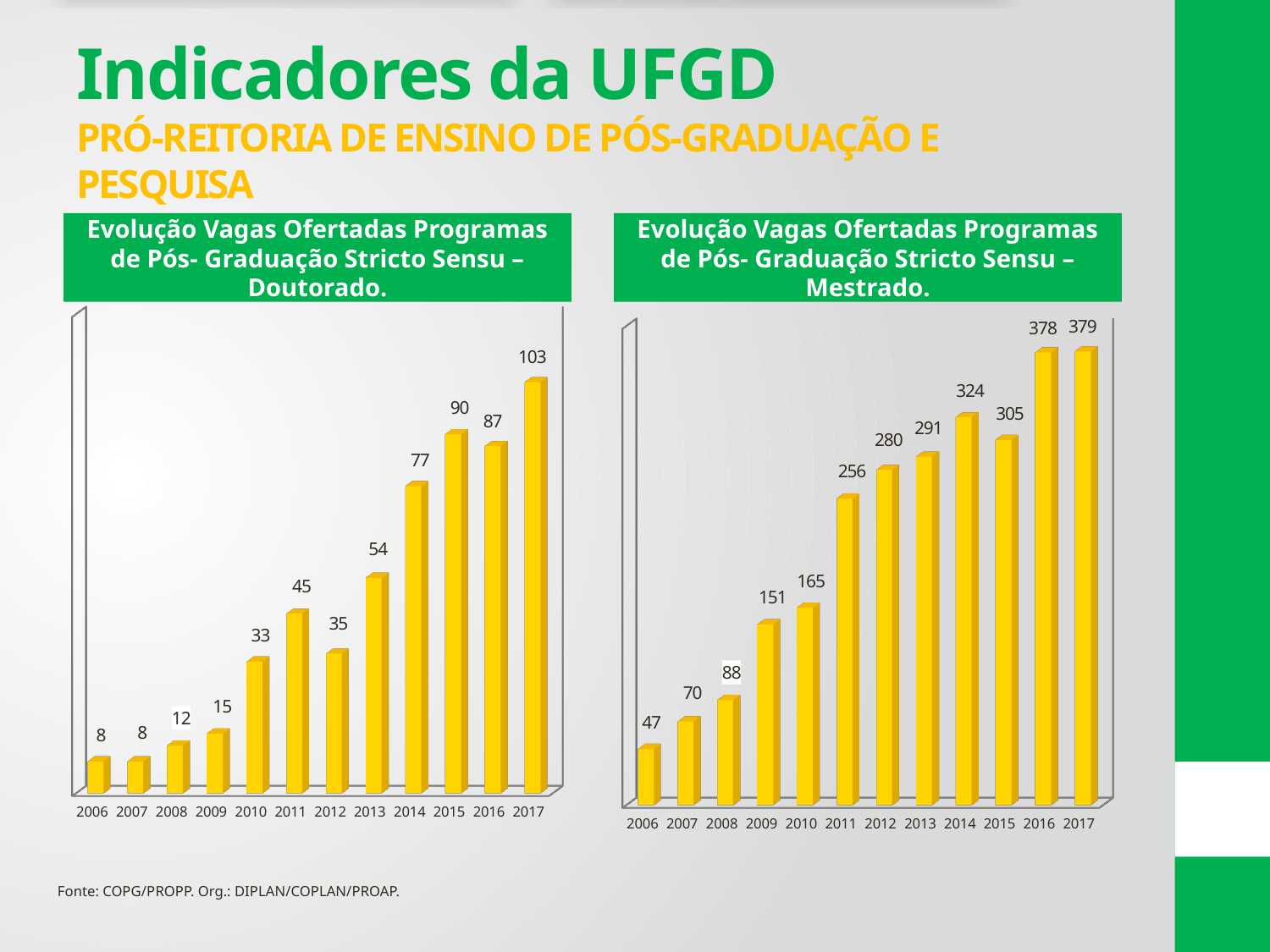
In the Mestrado chart (right), what is the value for 2011? 256 In the Mestrado chart (right), do the values generally rise or fall from 2006 to 2017? Rise In the Mestrado chart (right), which is larger, the value for 2009 or the value for 2010? 2010 In the Doutorado chart (left), which year has the highest value? 2017 In the Doutorado chart (left), which year has the lowest value? 2006 and 2007 How many years are shown on the x axis of the Mestrado chart (right)? 12 In the Mestrado chart (right), which year has the lowest value? 2006 What kind of chart is the Doutorado chart (left)? Bar chart In the Mestrado chart (right), what is the difference between the values for 2014 and 2015? 19 In the Doutorado chart (left), what is the value for 2017? 103 In the Doutorado chart (left), which is larger, the value for 2011 or the value for 2012? 2011 In the Doutorado chart (left), what is the difference between the values for 2015 and 2016? 3